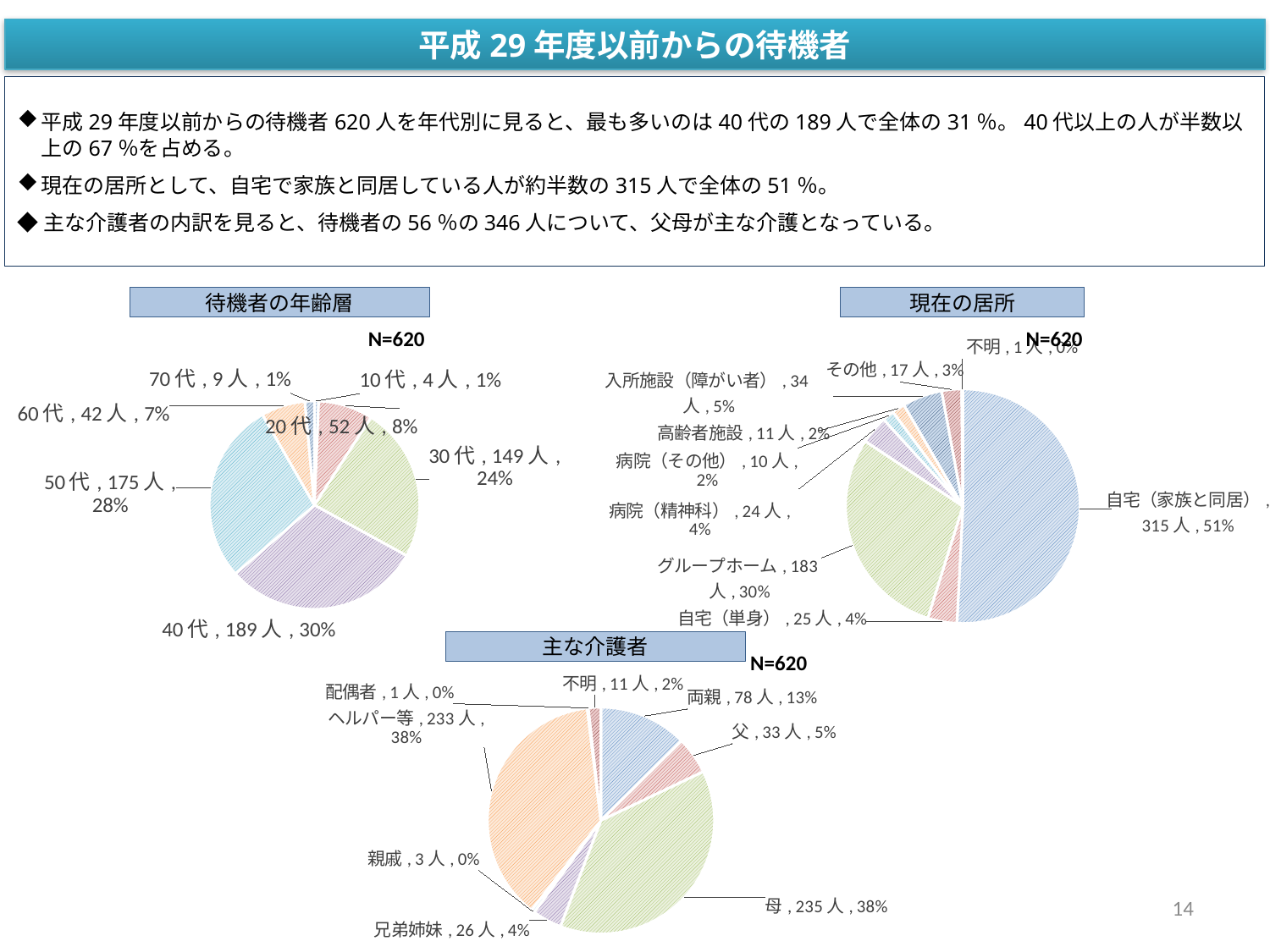
How many categories does the 待機者の年齢層 chart show? 7 In the 主な介護者 chart, how many people have 母 as their main caregiver? 235 人 In the 待機者の年齢層 chart, what is the difference in people between 50代 and 30代? 26 人 What is the N value shown for the 主な介護者 chart? N=620 In the 現在の居所 chart, what share of the total is グループホーム? 30% In the 現在の居所 chart, which category has the smallest number of people? 不明 In the 主な介護者 chart, what is the difference in people between 母 and ヘルパー等? 2 人 In the 待機者の年齢層 chart, which age group has the largest share? 40代 In the 現在の居所 chart, which is larger: 入所施設（障がい者） or 病院（精神科）? 入所施設（障がい者） In the 待機者の年齢層 chart, how many people are in the 40代 category? 189 人 What type of chart is the 現在の居所 chart? Pie chart How many categories does the 主な介護者 chart show? 8